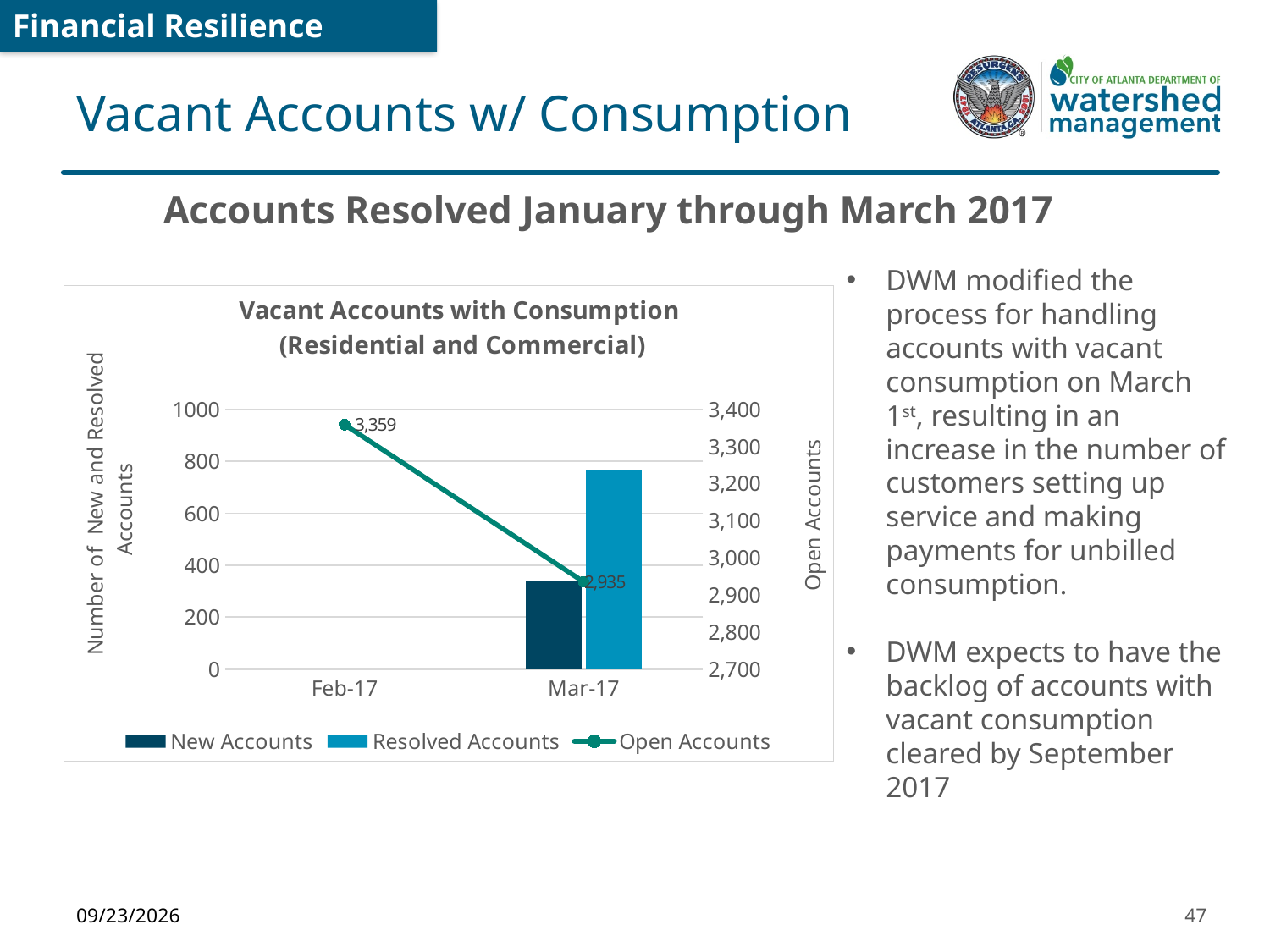
How many months are shown on the x axis of the chart? 2 In which month is the Open Accounts value highest? Feb-17 Is the value for New Accounts in Mar-17 greater or less than 400? less For Mar-17, which is larger: New Accounts or Resolved Accounts? Resolved Accounts What kind of chart is shown on the slide? Combination bar and line chart What is the value of Open Accounts for Feb-17? 3,359 What is the value of Open Accounts for Mar-17? 2,935 By how much did Open Accounts decrease from Feb-17 to Mar-17? 424 How many series does the chart legend list? 3 Does the Open Accounts line rise or fall from Feb-17 to Mar-17? Fall What is the label of the right-hand vertical axis of the chart? Open Accounts Is the value for Resolved Accounts in Mar-17 greater or less than 600? greater